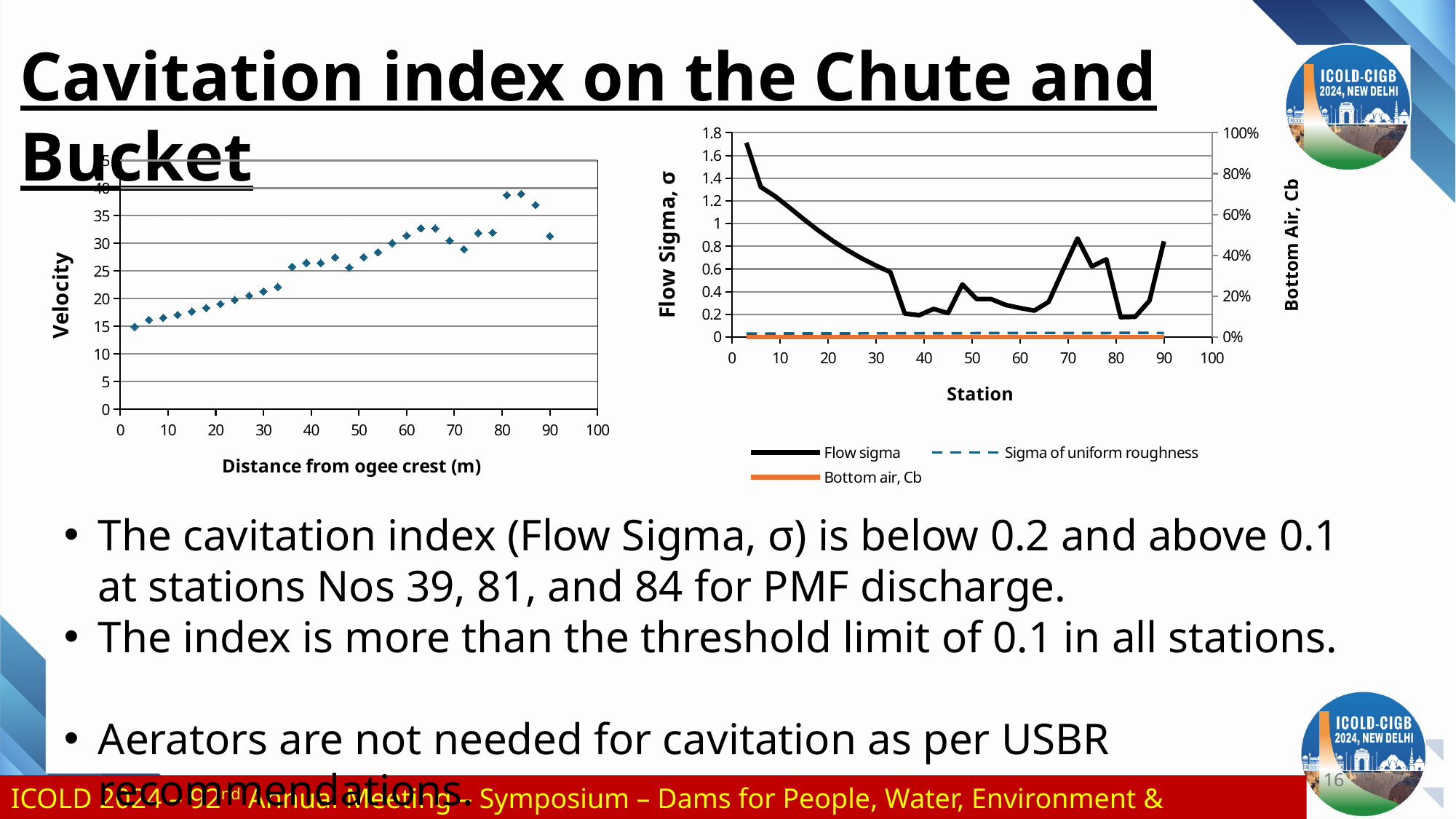
In the right chart, is the Flow sigma value at station 72 greater or less than 0.6? greater In the right chart, how many series does the legend list? 3 In the right chart, what is the title of the secondary (right-hand) vertical axis? Bottom Air, Cb In the left chart, is the velocity at the first point (near 3 m) greater or less than 20? less What kind of chart is the left chart showing Velocity against Distance from ogee crest? scatter chart In the right chart, is the Flow sigma value at station 40 greater or less than 0.4? less What kind of chart is the right chart showing Flow Sigma against Station? line chart In the left chart, do the velocity values generally rise or fall as distance from the ogee crest increases from 0 to 60 m? rise In the left chart, what is the title of the horizontal axis? Distance from ogee crest (m) In the right chart, does the Flow sigma line rise or fall between station 0 and station 30? fall